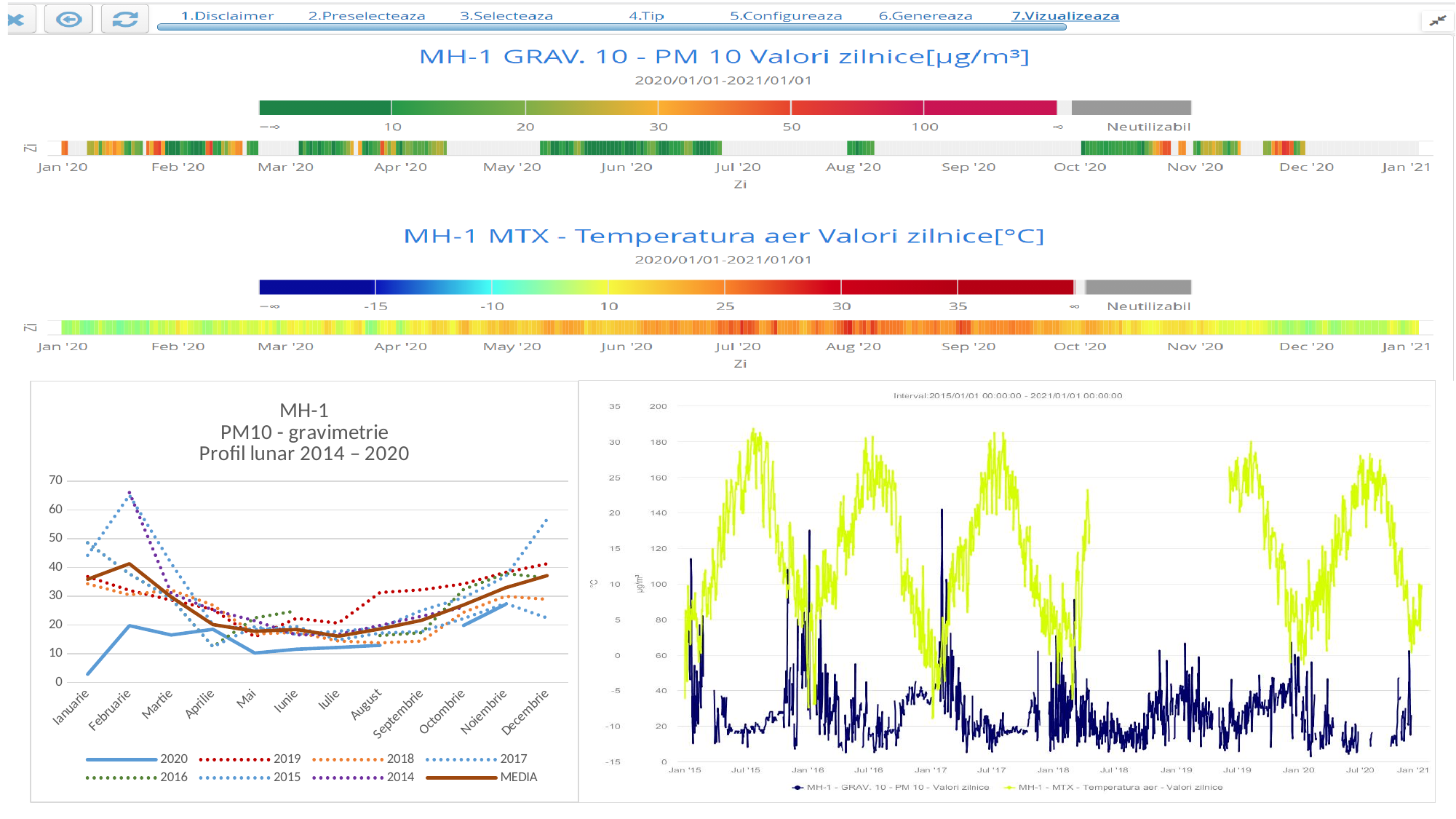
What date range is shown under the title of the top chart 'MH-1 GRAV. 10 - PM 10 Valori zilnice[µg/m³]'? 2020/01/01-2021/01/01 In the bottom-right time-series chart, which series is drawn in yellow-green? MH-1 - MTX - Temperatura aer - Valori zilnice How many series does the legend of the bottom-left chart 'MH-1 PM10 - gravimetrie Profil lunar 2014 – 2020' list? 8 In the bottom-left chart 'MH-1 PM10 - gravimetrie Profil lunar 2014 – 2020', does the MEDIA line rise or fall from Februarie to Iulie? fall In the bottom-left chart 'MH-1 PM10 - gravimetrie Profil lunar 2014 – 2020', is the value for 2020 in Ianuarie greater or less than 10? less In the bottom-left chart 'MH-1 PM10 - gravimetrie Profil lunar 2014 – 2020', how many months are shown on the x axis? 12 In the bottom-left chart 'MH-1 PM10 - gravimetrie Profil lunar 2014 – 2020', in which month is the MEDIA line highest? Februarie What kind of chart is the bottom-left chart titled 'MH-1 PM10 - gravimetrie Profil lunar 2014 – 2020'? line chart In the bottom-left chart 'MH-1 PM10 - gravimetrie Profil lunar 2014 – 2020', which is larger in Ianuarie: the 2020 value or the MEDIA value? MEDIA In the bottom-left chart 'MH-1 PM10 - gravimetrie Profil lunar 2014 – 2020', is the MEDIA value in Iulie greater or less than 20? less In the bottom-left chart 'MH-1 PM10 - gravimetrie Profil lunar 2014 – 2020', is the value for 2017 in Februarie greater or less than 60? greater How many series does the legend of the bottom-right time-series chart list? 2